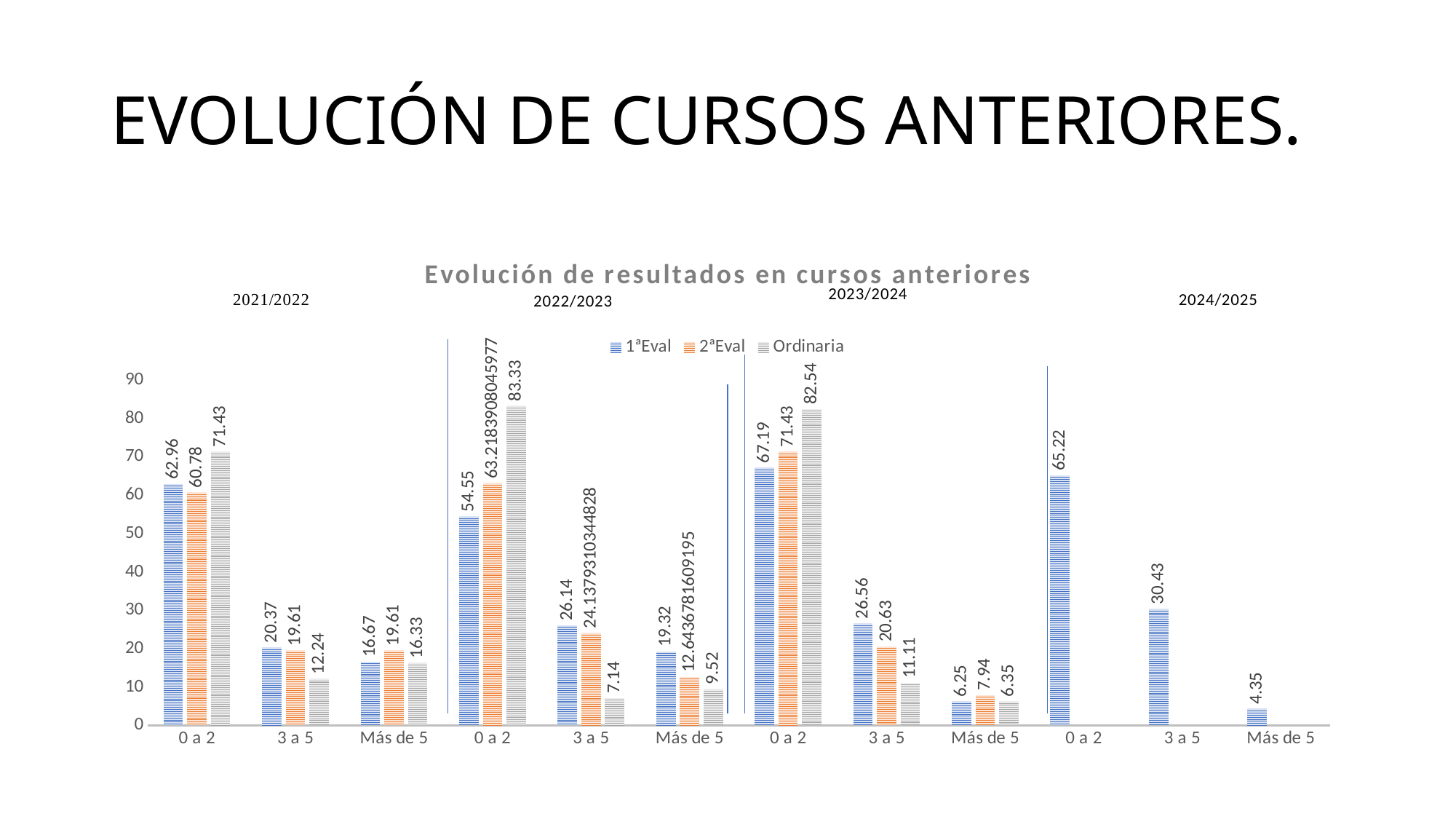
Which is larger for '3 a 5' in 2023/2024: the 1ªEval value or the 2ªEval value? 1ªEval (26.56) What is the 2ªEval value for 'Más de 5' in 2023/2024? 7.94 What is the title of the chart? Evolución de resultados en cursos anteriores What is the 1ªEval value for '3 a 5' in 2021/2022? 20.37 How many series does the legend list? 3 What is the difference between the Ordinaria and 1ªEval values for '0 a 2' in 2021/2022? 8.47 Which bar has the highest value in the whole chart? Ordinaria, 0 a 2, 2022/2023 (83.33) What is the Ordinaria value for '0 a 2' in 2022/2023? 83.33 What kind of chart is shown on the slide? Bar chart Is the Ordinaria value for '0 a 2' in 2023/2024 greater or less than 80? greater What is the 1ªEval value for '0 a 2' in 2024/2025? 65.22 Which bar has the lowest value in the whole chart? 1ªEval, Más de 5, 2024/2025 (4.35)